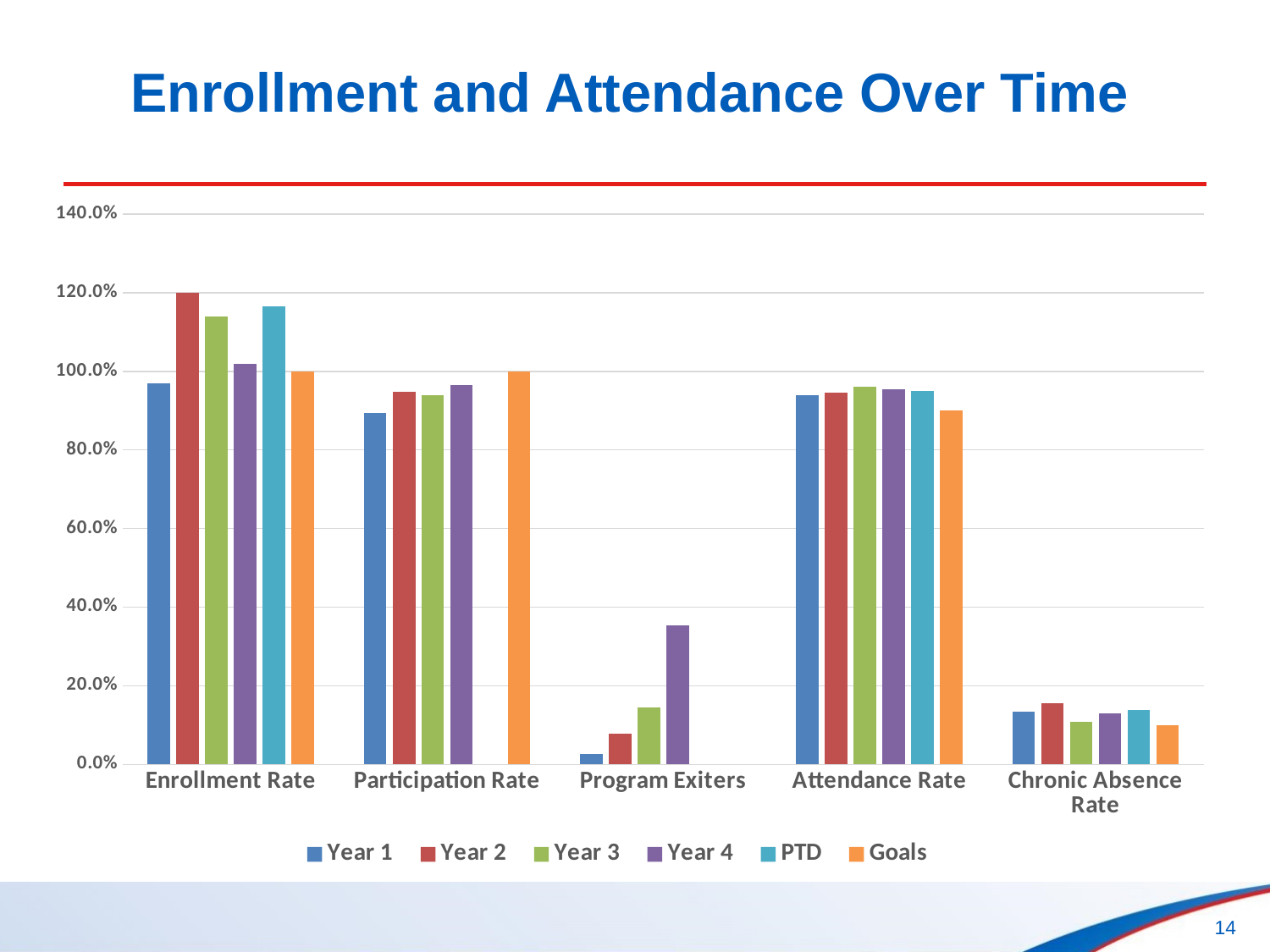
For Program Exiters, which series has the highest bar? Year 4 For Participation Rate, which series has the lowest bar? Year 1 What is the Goals value for Enrollment Rate? 100.0% How many series does the legend list? 6 What are the legend entries, in order? Year 1, Year 2, Year 3, Year 4, PTD, Goals Is the Year 3 value for Chronic Absence Rate greater or less than 20.0%? less What is the title of the slide's chart? Enrollment and Attendance Over Time Is the Year 4 value for Program Exiters greater or less than 20.0%? greater What is the Goals value for Participation Rate? 100.0% Is the Year 1 value for Enrollment Rate greater or less than 80.0%? greater How many categories are shown on the x axis? 5 What kind of chart is shown on the slide? bar chart